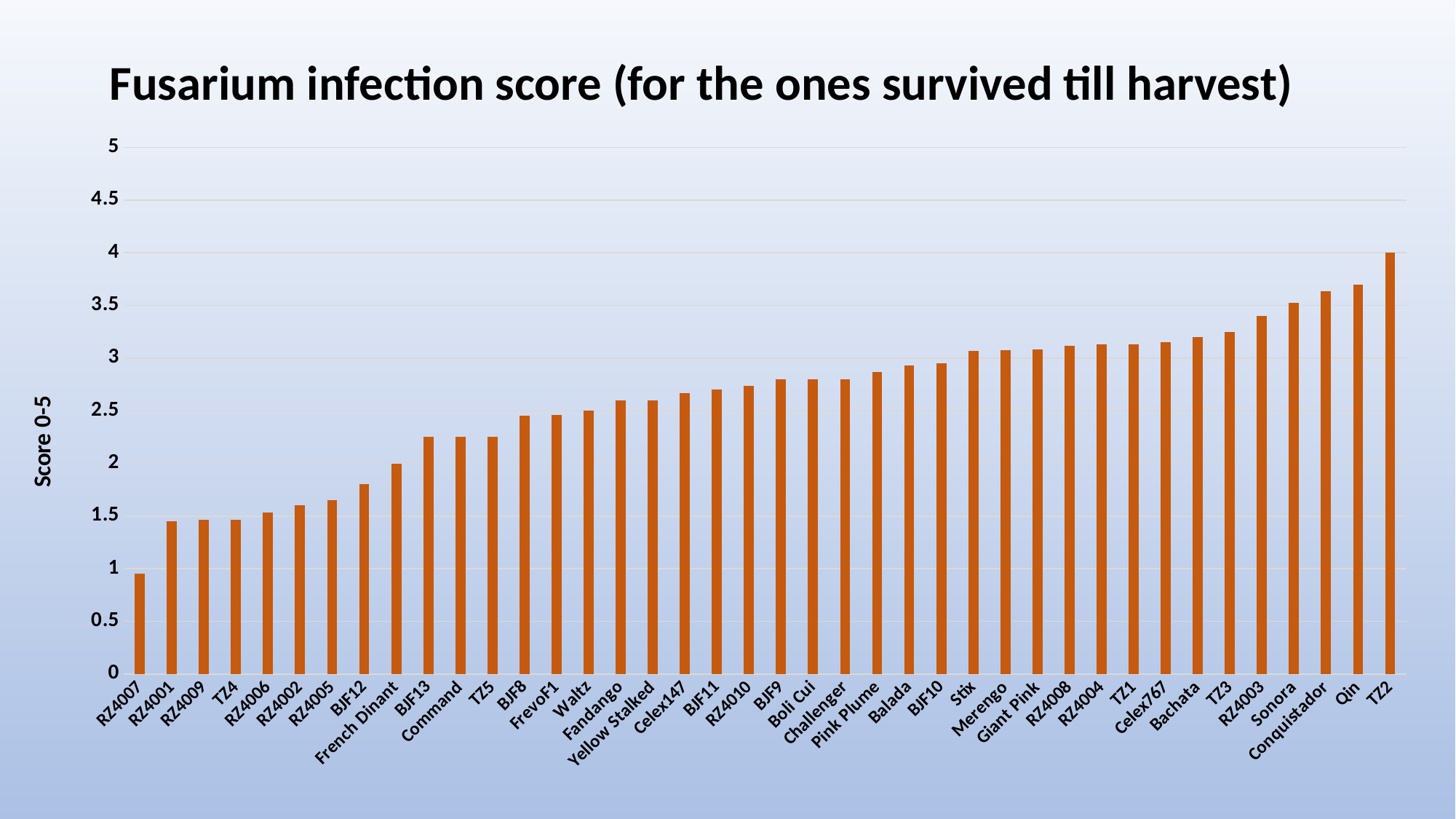
Is the value for BJF12 greater or less than 2? less Do the scores rise or fall moving from left to right along the x axis? rise What is the label on the vertical axis? Score 0-5 Is the value for Qin greater or less than 3.5? greater Which has the larger score, RZ4007 or RZ4001? RZ4001 Which variety has the highest Fusarium infection score? TZ2 Which has the larger score, Qin or Sonora? Qin How many varieties are plotted on the chart? 40 What kind of chart is shown on the slide? bar chart What is the title of the chart? Fusarium infection score (for the ones survived till harvest) Which variety has the lowest Fusarium infection score? RZ4007 Is the value for RZ4007 greater or less than 1? less